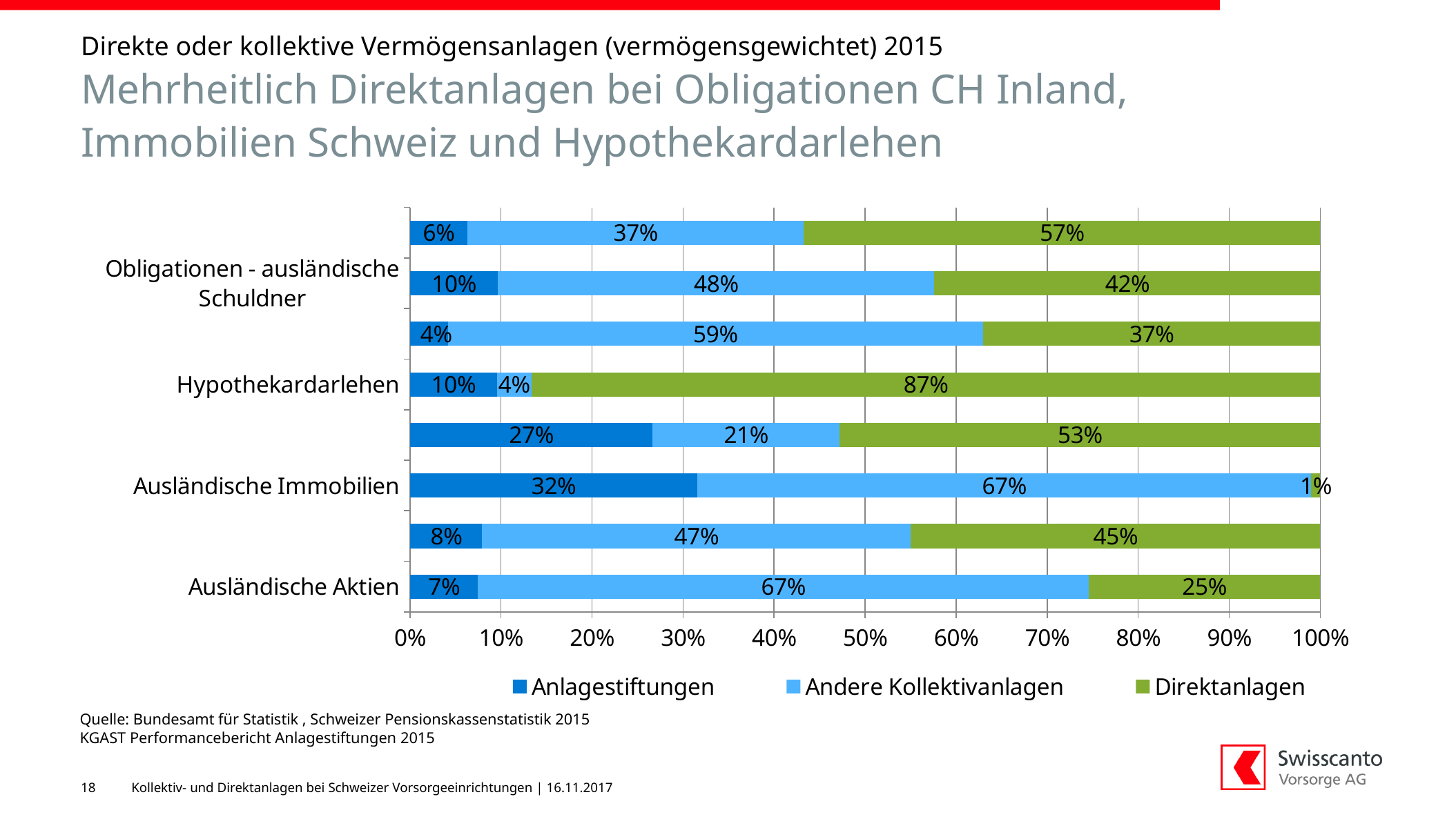
Which is larger: the Andere Kollektivanlagen share for Obligationen - ausländische Schuldner or for Hypothekardarlehen? Obligationen - ausländische Schuldner How many series does the legend list? 3 What is the Andere Kollektivanlagen share for Ausländische Immobilien? 67% What is the difference between the Direktanlagen share for Hypothekardarlehen and for Ausländische Aktien? 62% What is the Direktanlagen share for Hypothekardarlehen? 87% What kind of chart is shown on the slide? Stacked bar chart Among the labelled categories, which has the highest Direktanlagen share? Hypothekardarlehen What is the Anlagestiftungen share for Ausländische Immobilien? 32% What is the Direktanlagen share for Obligationen - ausländische Schuldner? 42% Among the labelled categories, which has the lowest Direktanlagen share? Ausländische Immobilien What is the Anlagestiftungen share for Ausländische Aktien? 7% Which legend entry is shown in green? Direktanlagen